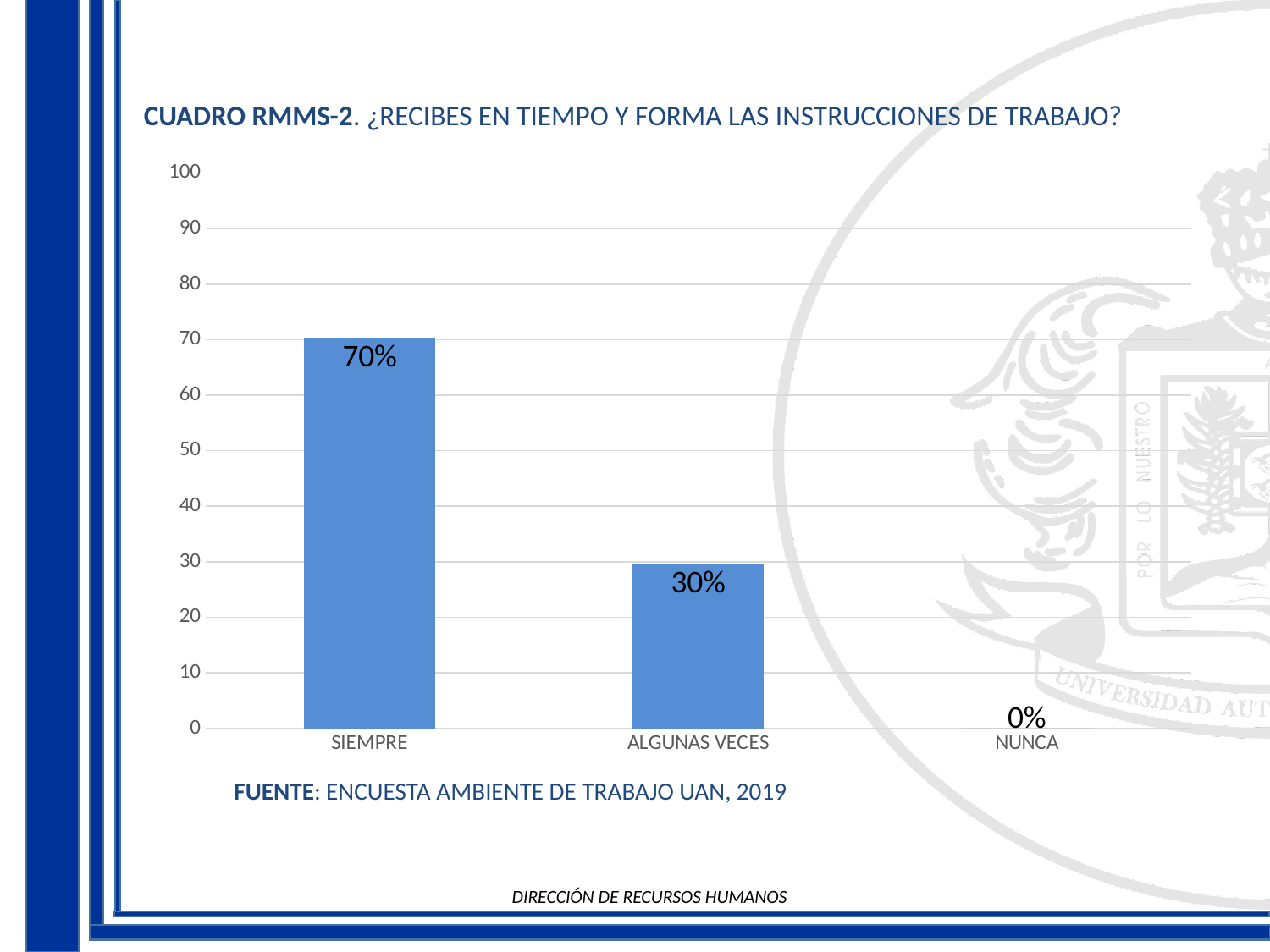
What is the value for ALGUNAS VECES? 30% Is the value for ALGUNAS VECES greater or less than 50? less How many categories are shown on the x axis? 3 Which is larger, the value for SIEMPRE or the value for ALGUNAS VECES? SIEMPRE What kind of chart is shown on the slide? bar chart Which category has the highest value? SIEMPRE Which category has the lowest value? NUNCA Do the values rise or fall from left to right along the x axis? fall What is the value for NUNCA? 0% What is the difference between the values for SIEMPRE and ALGUNAS VECES? 40% What source is cited below the chart? ENCUESTA AMBIENTE DE TRABAJO UAN, 2019 What is the value for SIEMPRE? 70%